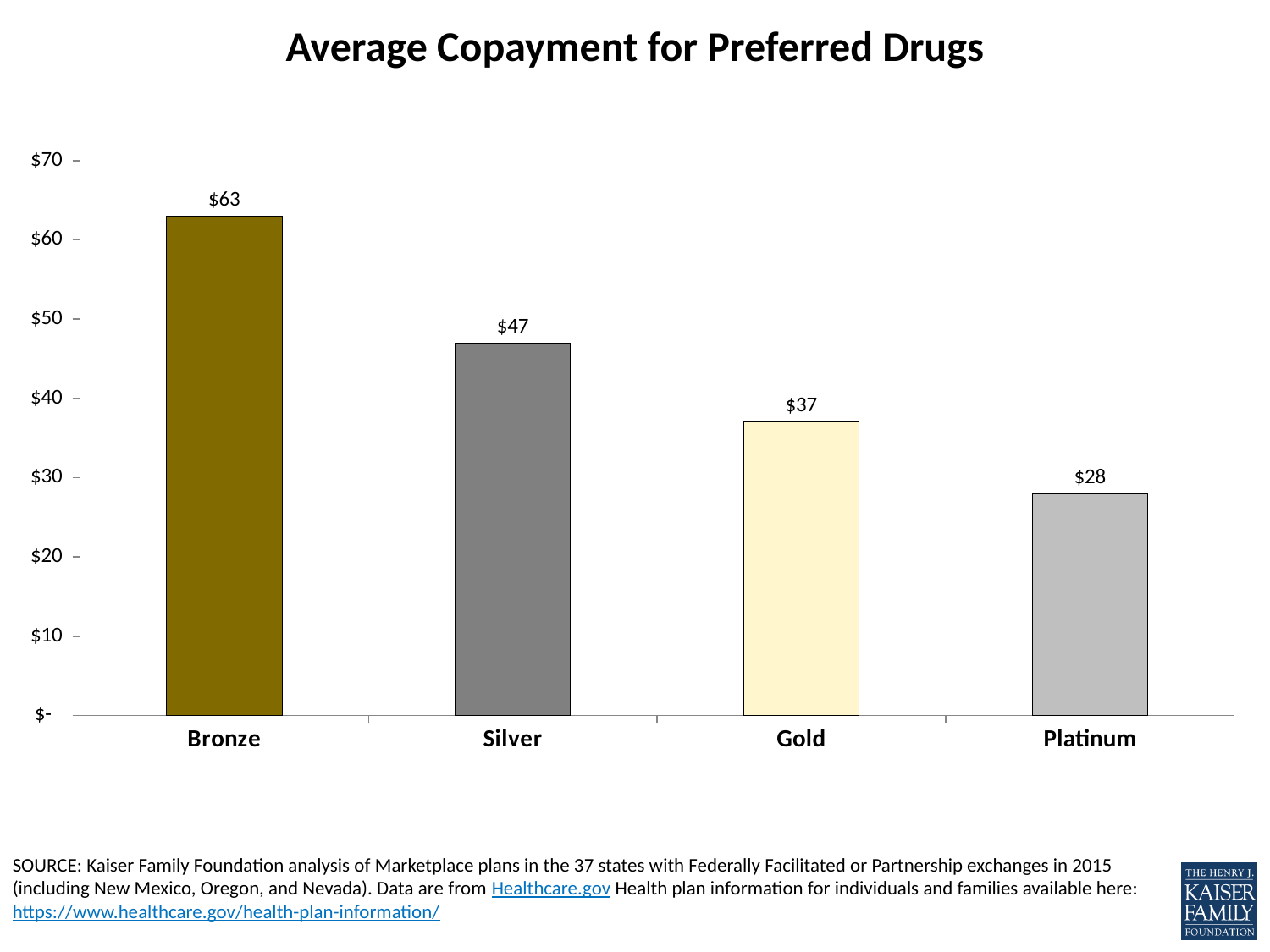
Do the average copayments rise or fall moving from Bronze to Platinum along the x axis? Fall What is the difference between the average copayment for Bronze and Platinum plans? $35 What is the average copayment for preferred drugs for Bronze plans? $63 What is the average copayment for preferred drugs for Silver plans? $47 How many plan types are shown in the chart? 4 Which plan type has the lowest average copayment for preferred drugs? Platinum What is the average copayment for preferred drugs for Gold plans? $37 Which plan type has the highest average copayment for preferred drugs? Bronze Which has a higher average copayment for preferred drugs, Silver or Gold? Silver What is the difference between the average copayment for Silver and Gold plans? $10 What is the average copayment for preferred drugs for Platinum plans? $28 What kind of chart is shown on the slide? Bar chart